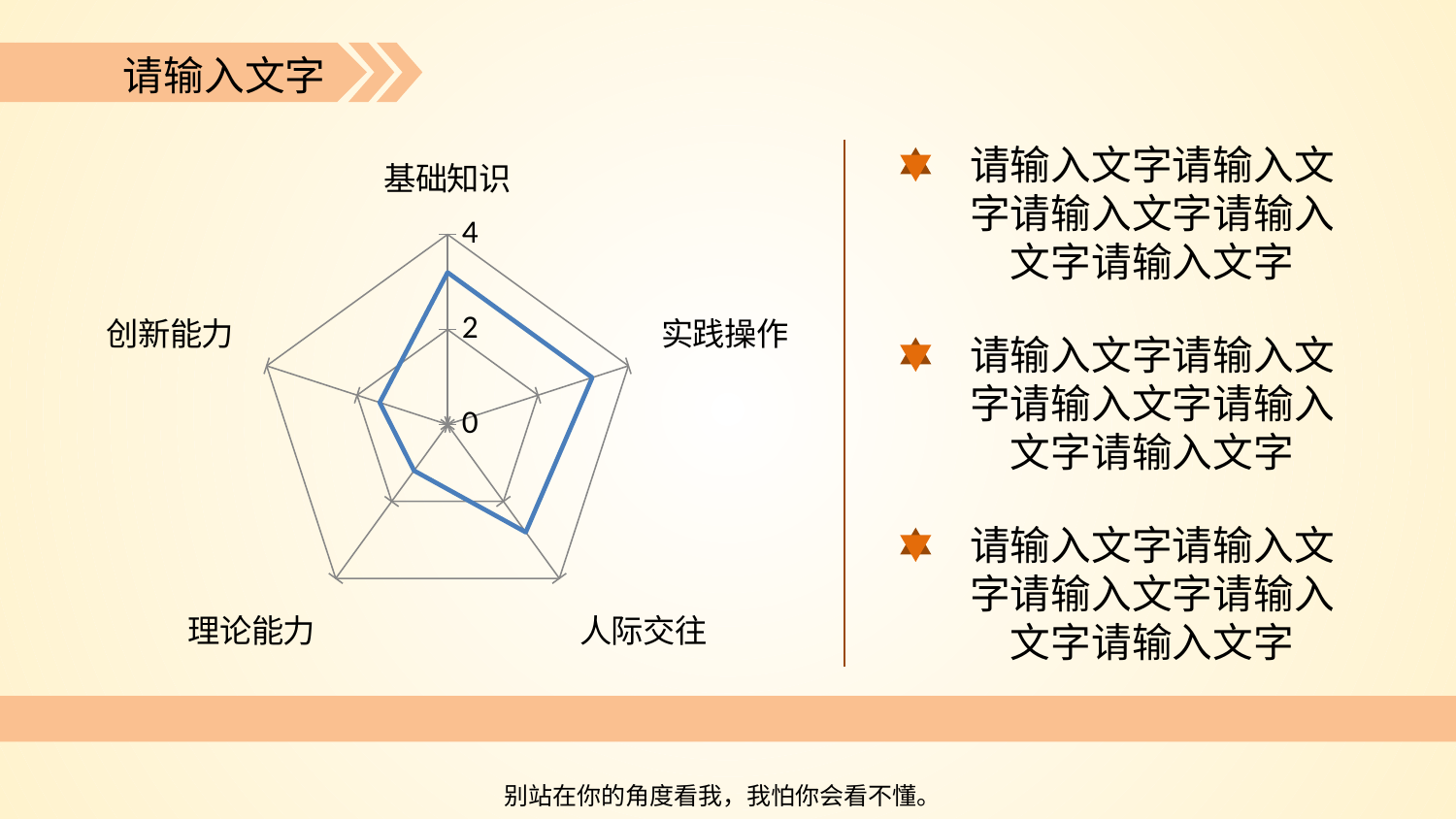
Which has the larger value, 实践操作 or 创新能力? 实践操作 Which category is placed at the top of the radar chart? 基础知识 Which has the larger value, 人际交往 or 理论能力? 人际交往 Is the value for 基础知识 greater or less than 2? greater Is the value for 人际交往 greater or less than 2? greater How many categories does the radar chart have? 5 What is the maximum value shown on the radar chart's axis scale? 4 What kind of chart is shown on the slide? radar chart Is the value for 实践操作 greater or less than 2? greater Which has the larger value, 基础知识 or 理论能力? 基础知识